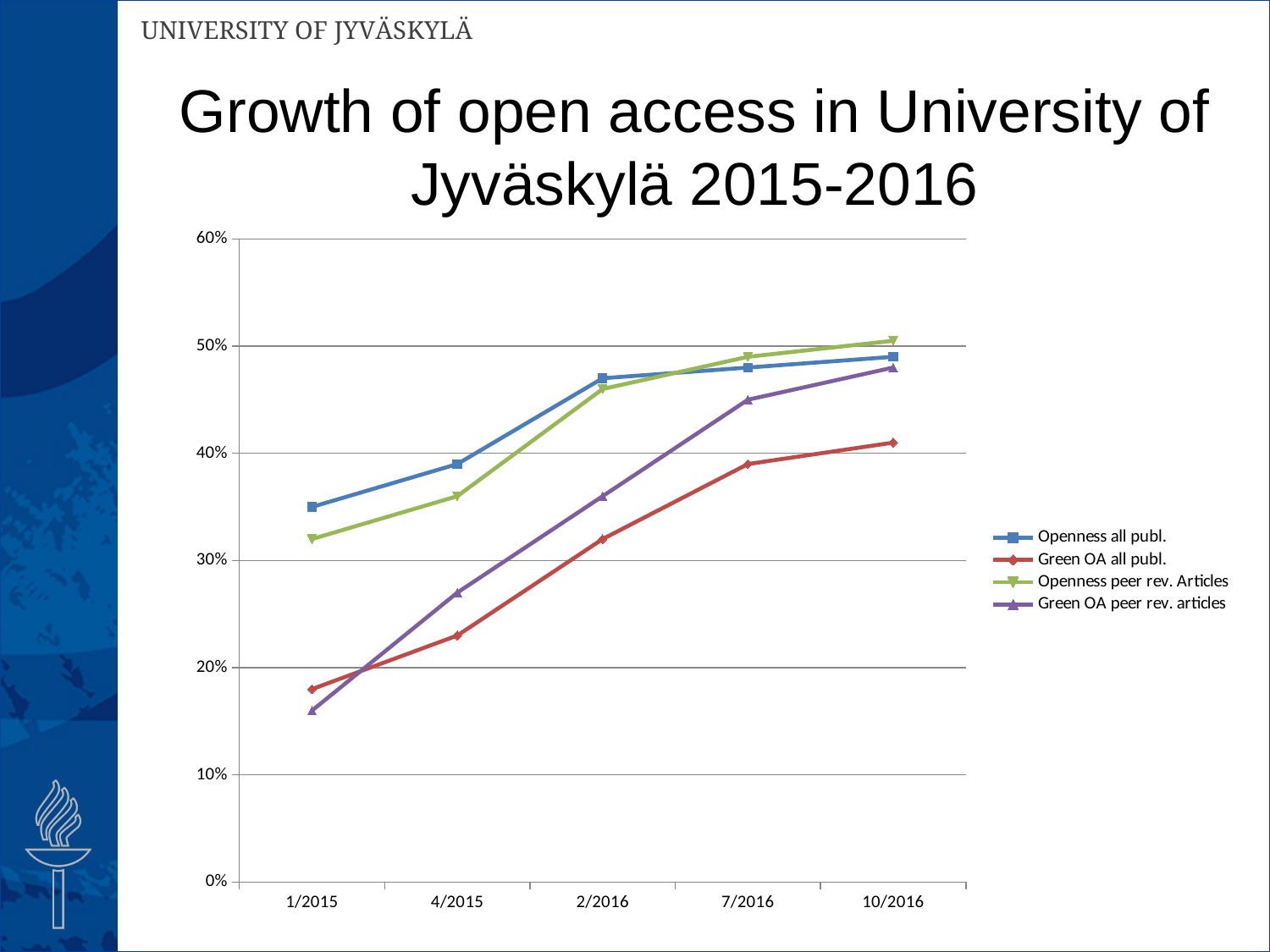
Which series has the highest value at 1/2015? Openness all publ. How many series does the legend list? 4 Is the value for Green OA all publ. at 1/2015 greater or less than 20%? less How many time points are shown on the x axis? 5 What kind of chart is shown on the slide? line chart Is the value for Openness all publ. at 1/2015 greater or less than 30%? greater Which series has the lowest value at 10/2016? Green OA all publ. At 10/2016, which is higher: Green OA all publ. or Green OA peer rev. articles? Green OA peer rev. articles What is the title of the chart? Growth of open access in University of Jyväskylä 2015-2016 Is the value for Green OA peer rev. articles at 10/2016 greater or less than 40%? greater Do the values for Green OA all publ. rise or fall from 1/2015 to 10/2016? rise